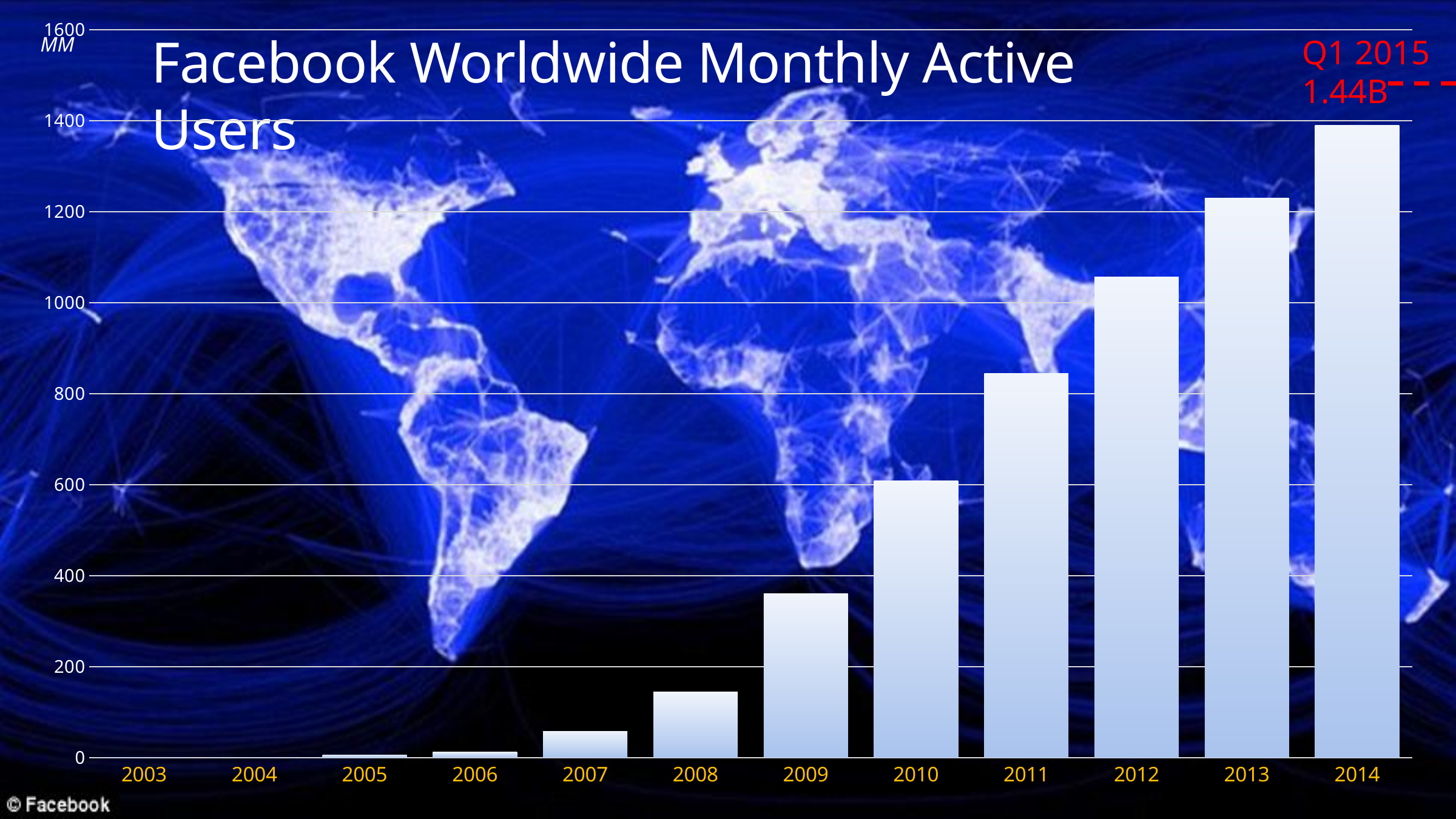
Is the value for 2010 greater or less than 400? greater What is the title of the chart? Facebook Worldwide Monthly Active Users What value does the red annotation give for Q1 2015? 1.44B Which year has the larger value, 2011 or 2012? 2012 Do the values rise or fall from 2003 to 2014? rise Which year has the highest bar in the chart? 2014 Is the value for 2009 greater or less than 400? less Is the value for 2008 greater or less than 200? less How many years are shown on the x axis of the chart? 12 What kind of chart is shown on the slide? bar chart